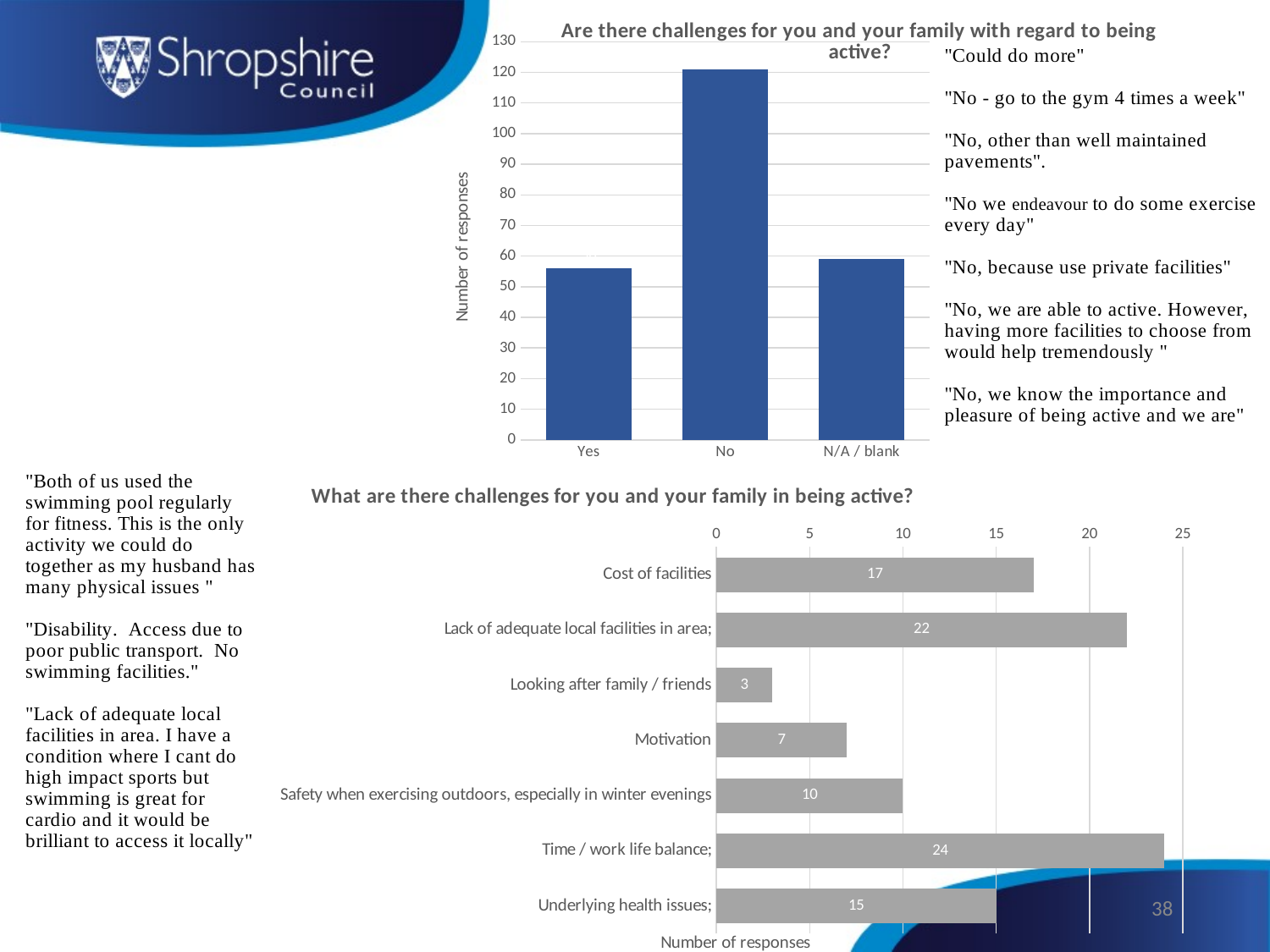
In the chart titled "Are there challenges for you and your family with regard to being active?", how many categories are shown on the x axis? 3 In the chart titled "Are there challenges for you and your family with regard to being active?", is the value for No greater or less than 100? greater In the chart titled "What are there challenges for you and your family in being active?", what is the value for Cost of facilities? 17 In the chart titled "What are there challenges for you and your family in being active?", how many categories are shown? 7 In the chart titled "What are there challenges for you and your family in being active?", what is the value for Safety when exercising outdoors, especially in winter evenings? 10 In the chart titled "What are there challenges for you and your family in being active?", which is larger: Cost of facilities or Underlying health issues? Cost of facilities What kind of chart is the one titled "What are there challenges for you and your family in being active?"? Bar chart In the chart titled "What are there challenges for you and your family in being active?", which category has the highest value? Time / work life balance; In the chart titled "What are there challenges for you and your family in being active?", which category has the lowest value? Looking after family / friends In the chart titled "Are there challenges for you and your family with regard to being active?", which category has the highest number of responses? No In the chart titled "What are there challenges for you and your family in being active?", what is the difference between Time / work life balance and Lack of adequate local facilities in area? 2 In the chart titled "What are there challenges for you and your family in being active?", what is the value for Motivation? 7